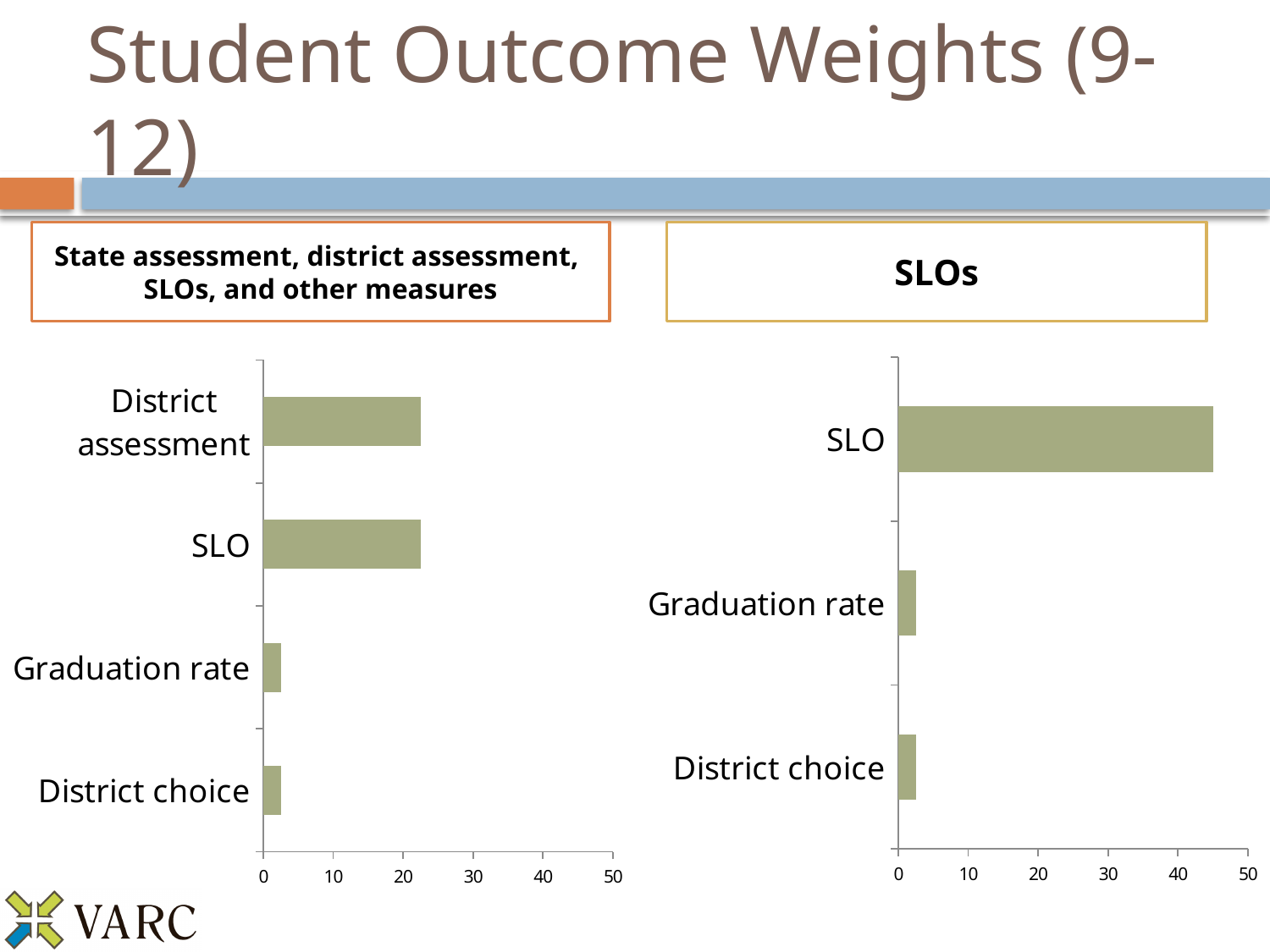
In the right chart (SLOs), is the value for SLO greater or less than 40? greater In the right chart (SLOs), which is larger: SLO or District choice? SLO How many categories does the right chart (SLOs) show? 3 How many categories does the left chart show? 4 In the left chart, is the value for Graduation rate greater or less than 10? less What is the title shown above the right chart? SLOs In the right chart (SLOs), which category has the highest value? SLO In the left chart, is the value for District assessment greater or less than 20? greater What kind of chart is the left chart on the slide? bar chart In the left chart, which is larger: District assessment or Graduation rate? District assessment